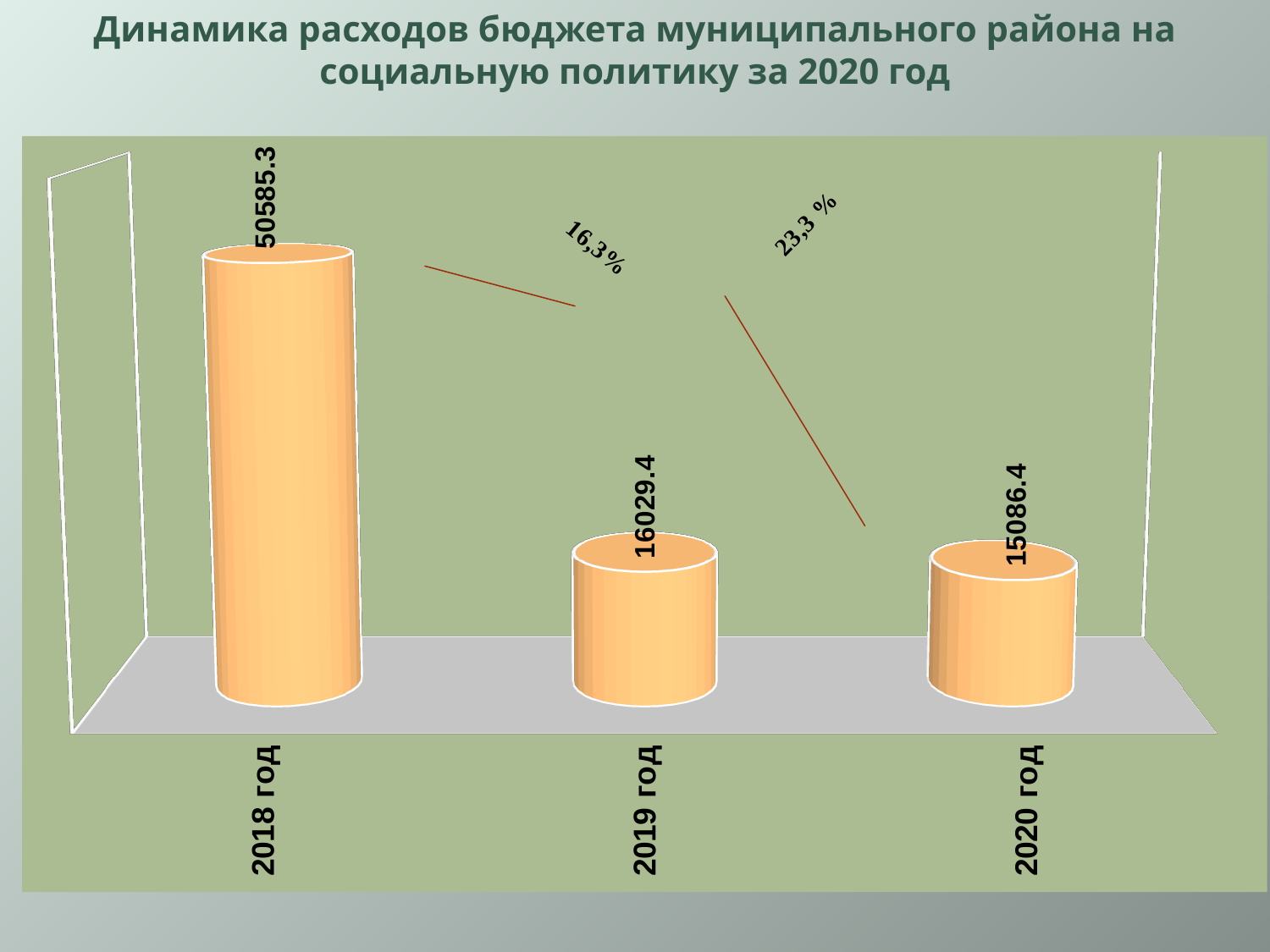
What is the value shown for 2018 год? 50585.3 What is the difference between the values for 2019 год and 2020 год? 943.0 What percentage annotation is written near the 2019 год bar? 16,3% What is the difference between the values for 2018 год and 2019 год? 34555.9 What is the value shown for 2019 год? 16029.4 Do the values rise or fall from 2018 год to 2020 год? Fall Which year has the lowest value on the chart? 2020 год Which is larger, the value for 2018 год or the value for 2020 год? 2018 год Which year has the highest value on the chart? 2018 год What is the value shown for 2020 год? 15086.4 How many years (categories) are plotted on the chart? 3 What kind of chart is shown on the slide? Bar chart